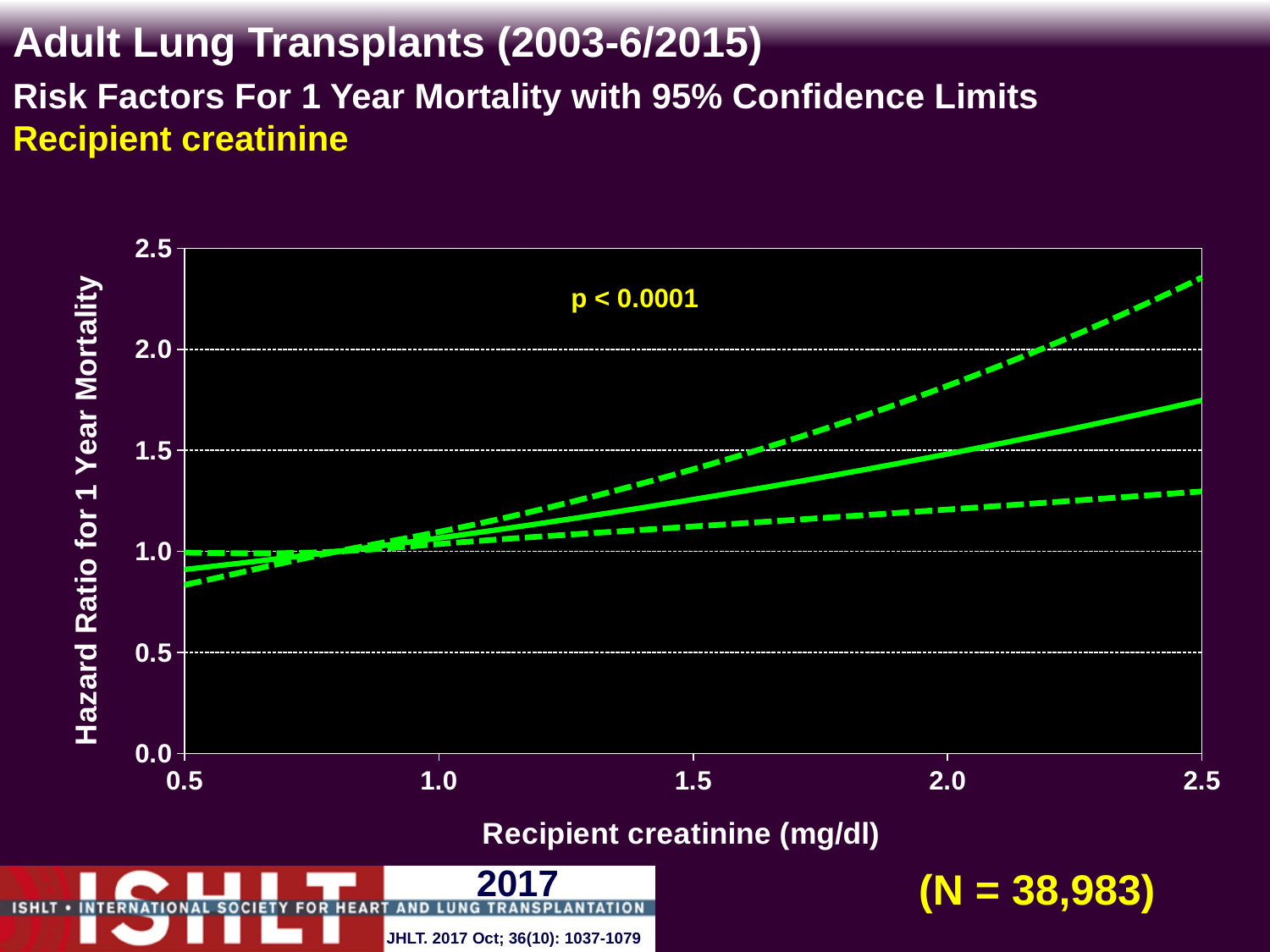
Is the hazard ratio (solid line) at a recipient creatinine of 1.5 mg/dl greater or less than 1.0? greater Is the hazard ratio (solid line) at a recipient creatinine of 2.5 mg/dl greater or less than 1.5? greater What is the sample size (N) shown on the slide? N = 38,983 How many lines are plotted on the chart? 3 Does the hazard ratio for 1 year mortality rise or fall as recipient creatinine increases from 0.5 to 2.5 mg/dl? Rise What kind of chart is shown on the slide? Line chart Is the hazard ratio (solid line) at a recipient creatinine of 2.5 mg/dl greater or less than 2.0? less What p-value is printed on the chart? p < 0.0001 At which recipient creatinine value is the hazard ratio (solid line) higher: 1.0 mg/dl or 2.0 mg/dl? 2.0 mg/dl